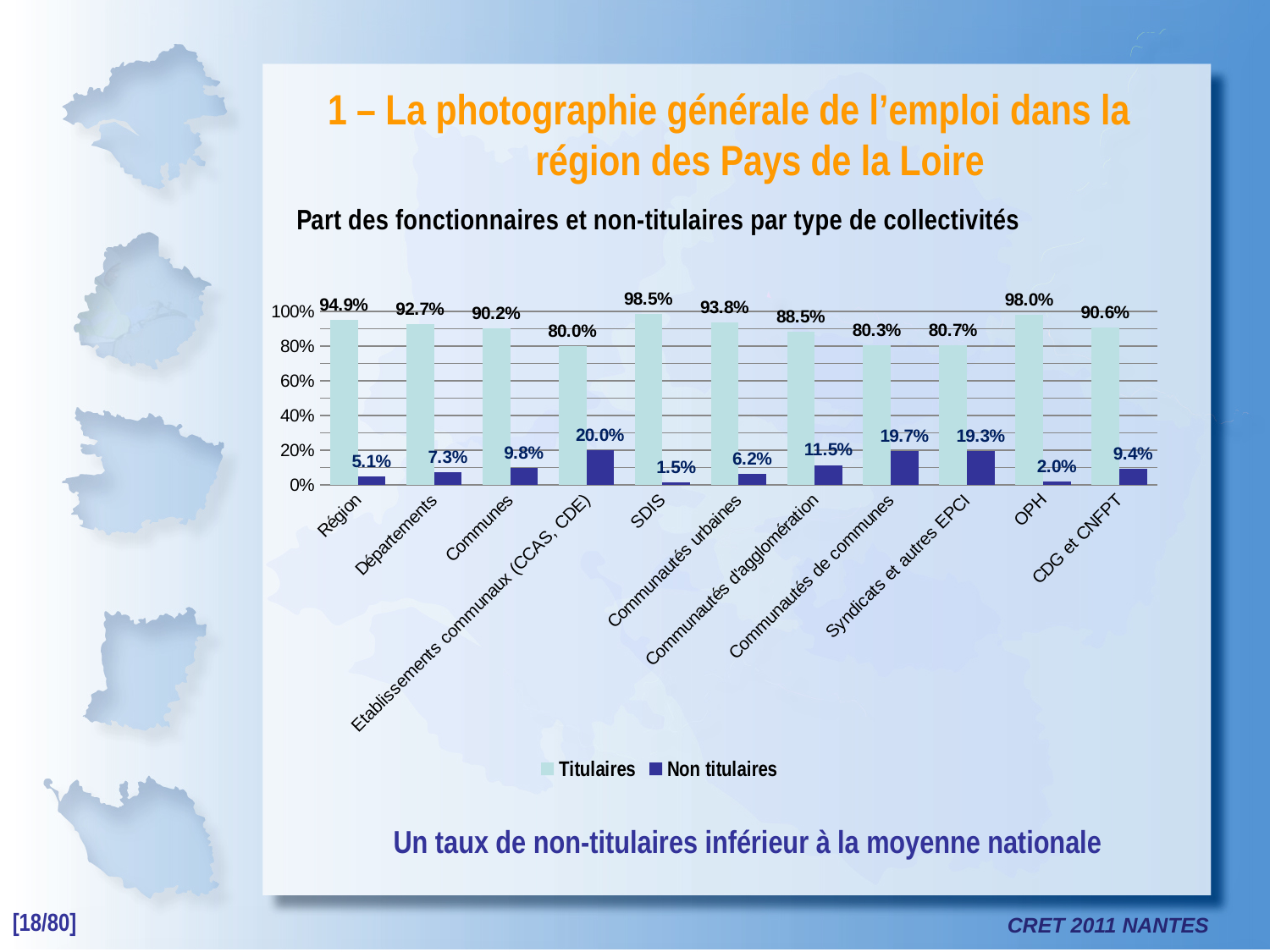
How many series does the legend list? 2 Which is larger, the Non titulaires value for Communautés de communes or for Syndicats et autres EPCI? Communautés de communes Which category has the lowest Non titulaires value? SDIS What kind of chart is shown on the slide? Bar chart What is the Non titulaires value for Etablissements communaux (CCAS, CDE)? 20.0% Which category has the lowest Titulaires value? Etablissements communaux (CCAS, CDE) What is the Non titulaires value for SDIS? 1.5% What is the difference between the Titulaires values for OPH and Communes? 7.8% What is the title of the chart? Part des fonctionnaires et non-titulaires par type de collectivités How many categories are shown on the x axis? 11 What is the Titulaires value for Région? 94.9% Which category has the highest Titulaires value? SDIS